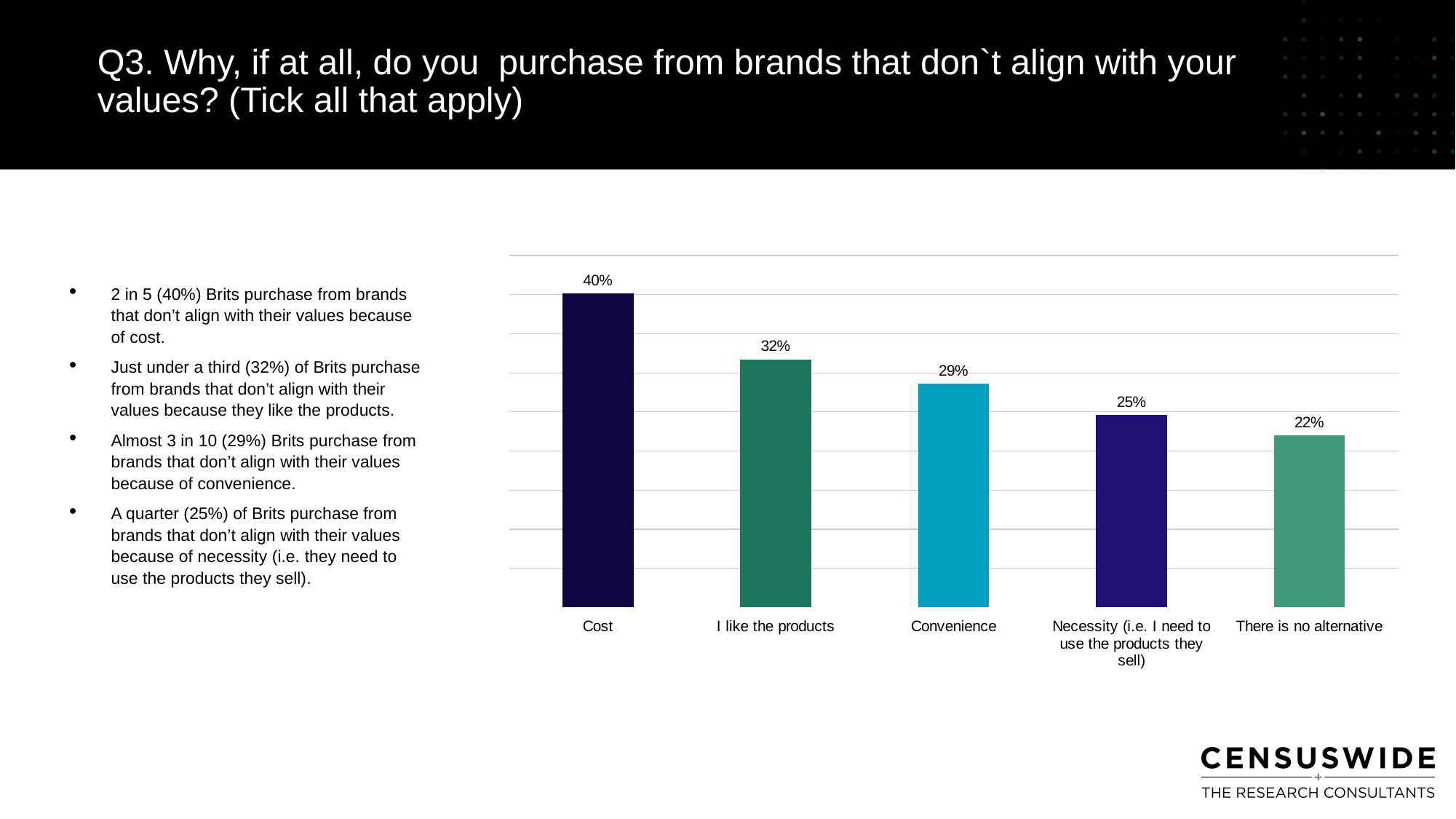
What is the difference between the values for 'Necessity (i.e. I need to use the products they sell)' and 'There is no alternative'? 3% What is the value shown for 'I like the products'? 32% Which category has the lowest value in the chart? There is no alternative What is the value shown for 'There is no alternative'? 22% What type of chart is shown on the slide? Bar chart What is the value shown for 'Convenience'? 29% How many categories are shown in the chart? 5 What is the difference between the values for 'Cost' and 'I like the products'? 8% Which category has the highest value in the chart? Cost Which is larger, the value for 'Convenience' or the value for 'Necessity (i.e. I need to use the products they sell)'? Convenience What percentage of respondents said they purchase from brands that don't align with their values because of cost? 40% Do the values rise or fall moving from left to right across the categories? Fall